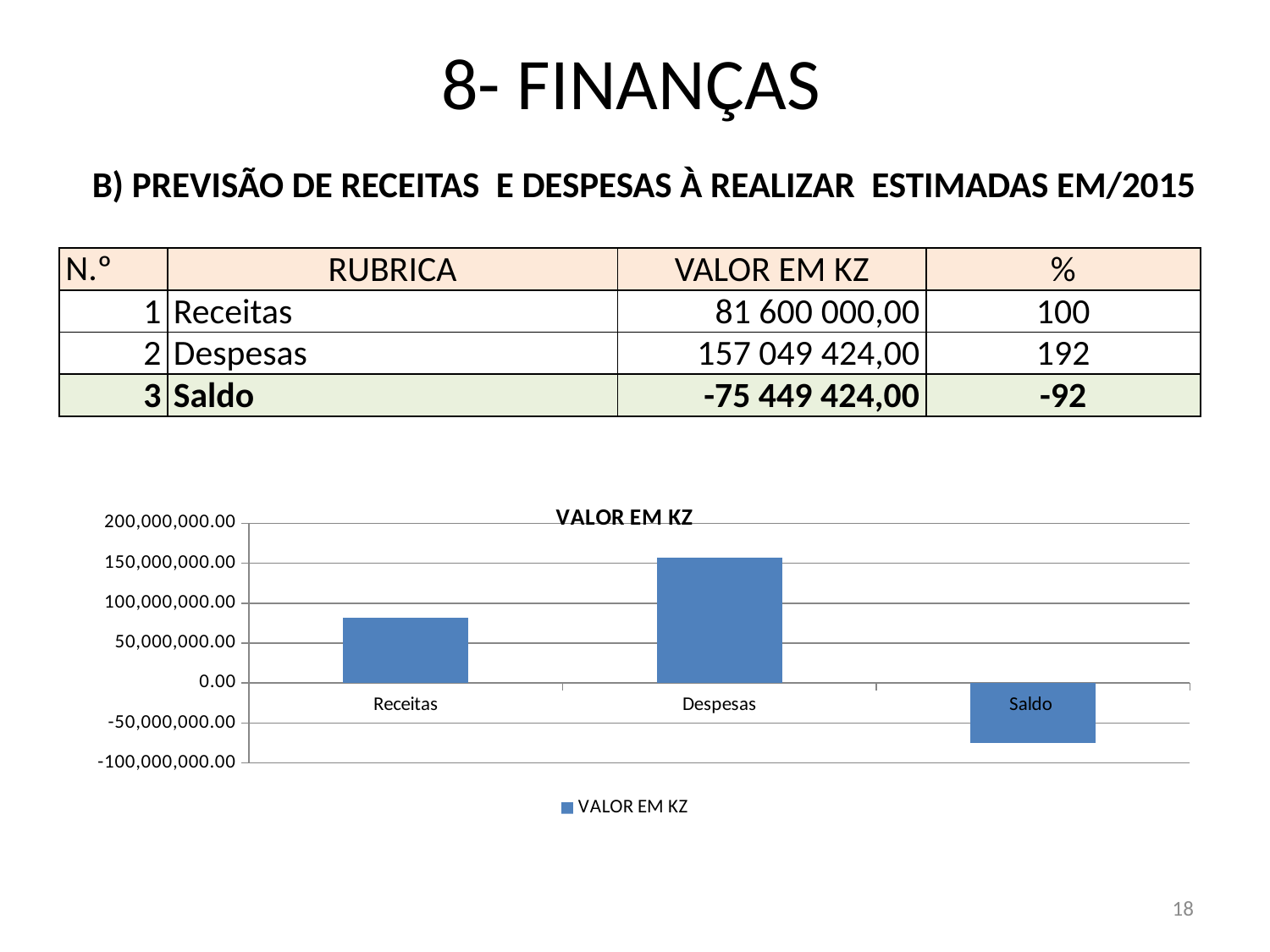
Is the value for Saldo greater or less than 0.00? less Which category has the lowest value in the chart? Saldo How many series does the chart legend list? 1 Is the value for Despesas greater or less than 150,000,000.00? greater Which category has the highest value in the chart? Despesas What kind of chart is shown on the slide? bar chart According to the slide, what is the value in KZ for Saldo? -75 449 424,00 According to the slide, what is the value in KZ for Despesas? 157 049 424,00 How many categories are plotted in the chart? 3 Which is larger, the value for Receitas or the value for Despesas? Despesas Is the value for Receitas greater or less than 100,000,000.00? less What is the title of the chart? VALOR EM KZ